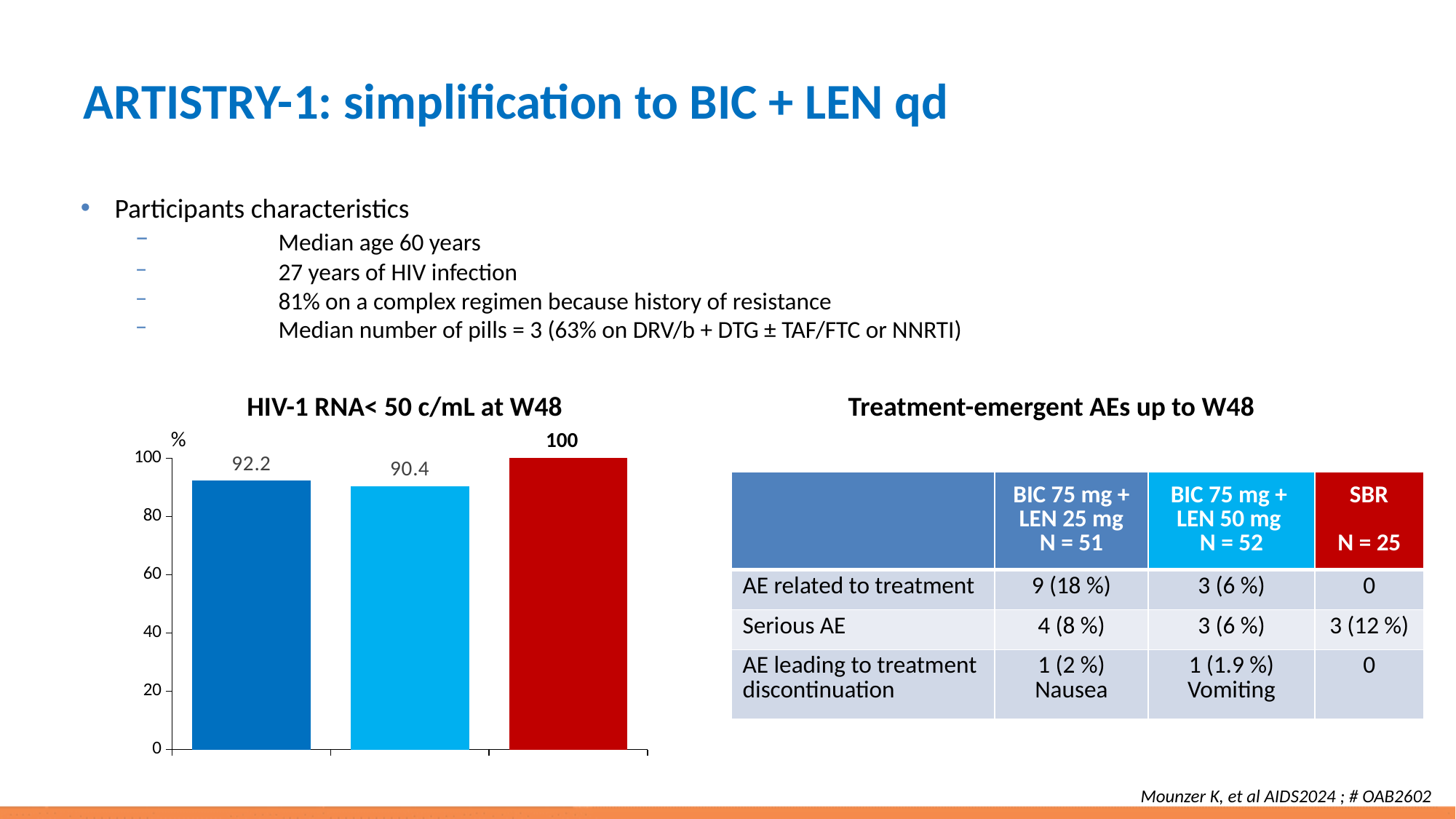
In the "HIV-1 RNA< 50 c/mL at W48" chart, which is larger, the dark blue bar or the light blue bar? the dark blue bar In the "HIV-1 RNA< 50 c/mL at W48" chart, what is the difference between the red bar and the dark blue bar? 7.8 In the "HIV-1 RNA< 50 c/mL at W48" chart, what is the maximum value shown on the y axis? 100 In the "HIV-1 RNA< 50 c/mL at W48" chart, what is the value of the rightmost (red) bar? 100 In the "HIV-1 RNA< 50 c/mL at W48" chart, what is the value of the middle (light blue) bar? 90.4 In the "HIV-1 RNA< 50 c/mL at W48" chart, what is the value of the leftmost (dark blue) bar? 92.2 What unit label is shown at the top of the y axis in the "HIV-1 RNA< 50 c/mL at W48" chart? % How many bars are plotted in the "HIV-1 RNA< 50 c/mL at W48" chart? 3 What kind of chart is shown under the title "HIV-1 RNA< 50 c/mL at W48"? bar chart In the "HIV-1 RNA< 50 c/mL at W48" chart, which bar has the lowest value? the light blue (middle) bar In the "HIV-1 RNA< 50 c/mL at W48" chart, which bar has the highest value? the red (rightmost) bar In the "HIV-1 RNA< 50 c/mL at W48" chart, what is the difference between the dark blue bar and the light blue bar? 1.8